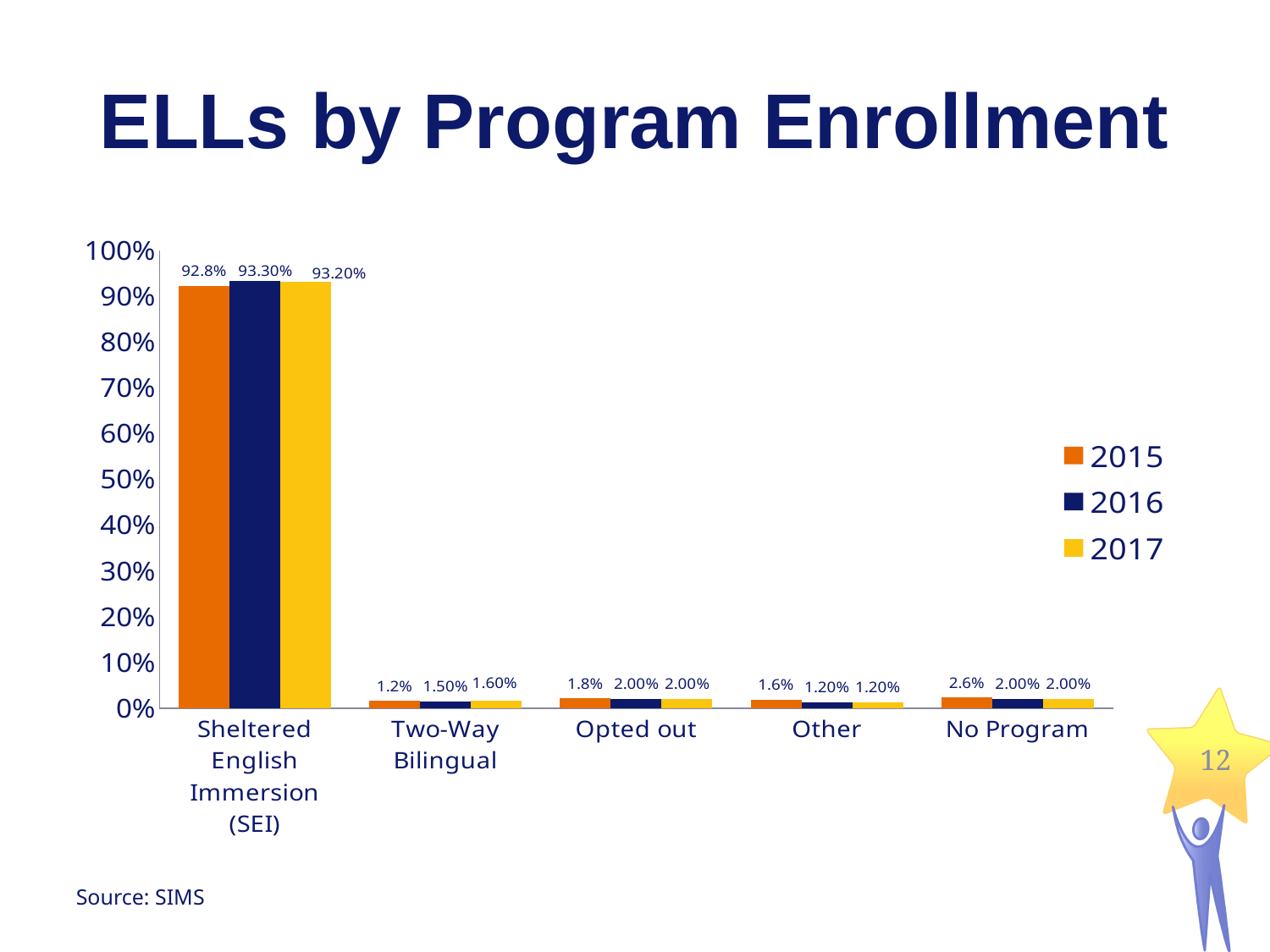
Which is larger for Opted out: the 2015 value or the 2016 value? 2016 What kind of chart is shown on the slide? Bar chart Which program category has the lowest 2015 value? Two-Way Bilingual What is the title of the slide? ELLs by Program Enrollment How many series does the legend list? 3 What is the 2015 value for Other? 1.6% What is the 2016 value for No Program? 2.00% What is the 2015 value for Sheltered English Immersion (SEI)? 92.8% Which program category has the highest enrollment share in 2016? Sheltered English Immersion (SEI) What is the difference between the 2016 and 2015 values for Sheltered English Immersion (SEI)? 0.5% How many program categories are shown on the x axis? 5 What is the 2017 value for Two-Way Bilingual? 1.60%